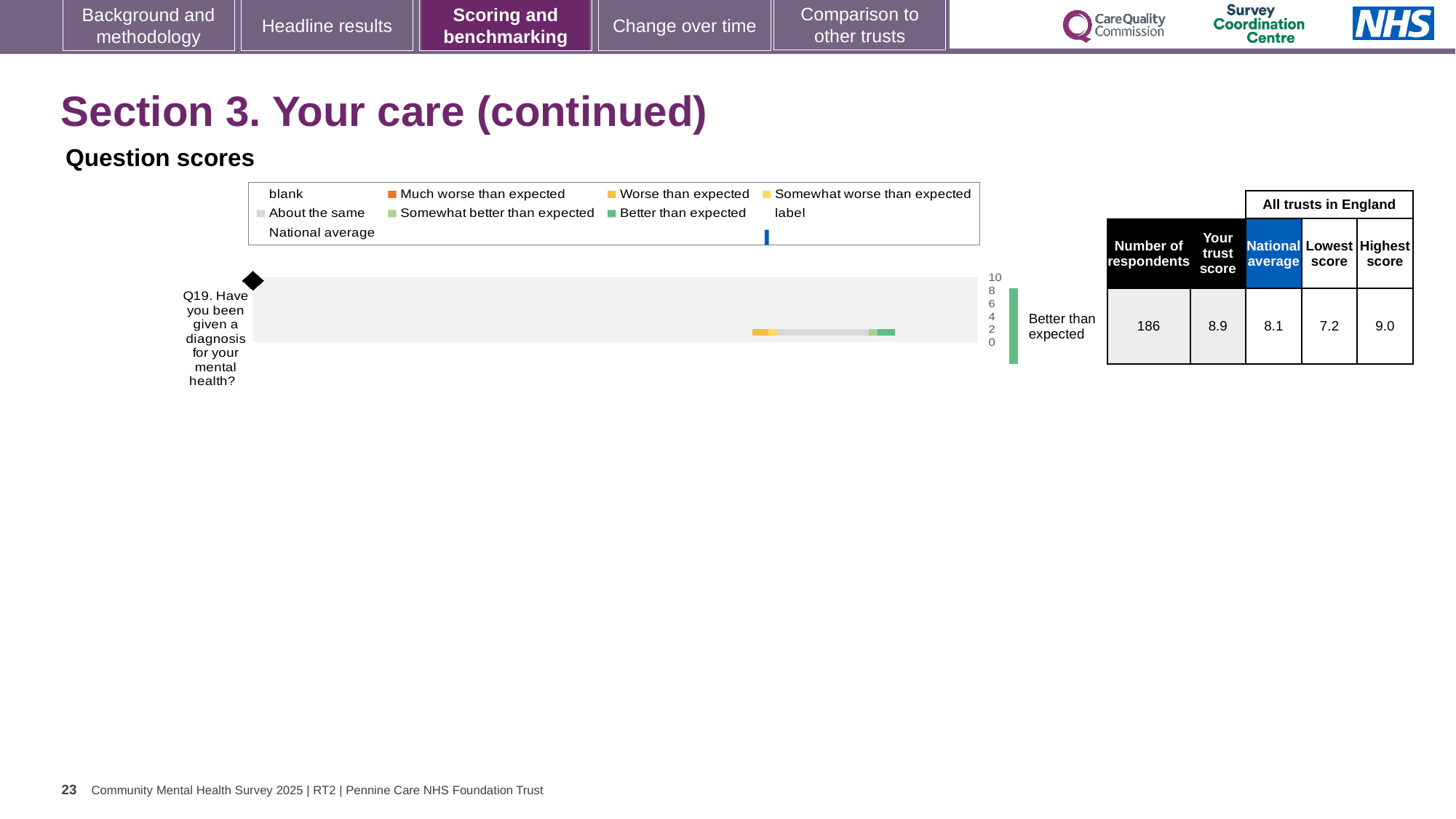
What is the lowest score among all trusts in England for Q19? 7.2 Which is larger for Q19: the trust's score or the national average? The trust's score What is the difference between the highest and lowest scores for Q19 across all trusts in England? 1.8 How many questions are plotted on the chart? 1 What is the trust's score for Q19? 8.9 Which benchmarking category is the trust's Q19 score placed in? Better than expected By how much does the trust's score for Q19 exceed the national average? 0.8 What colour does the legend use for the 'Better than expected' category? Green What is the highest score among all trusts in England for Q19? 9.0 What is the number of respondents for Q19 (Have you been given a diagnosis for your mental health?)? 186 What kind of chart is used to show the Q19 question score? Bar chart What is the national average score for Q19? 8.1